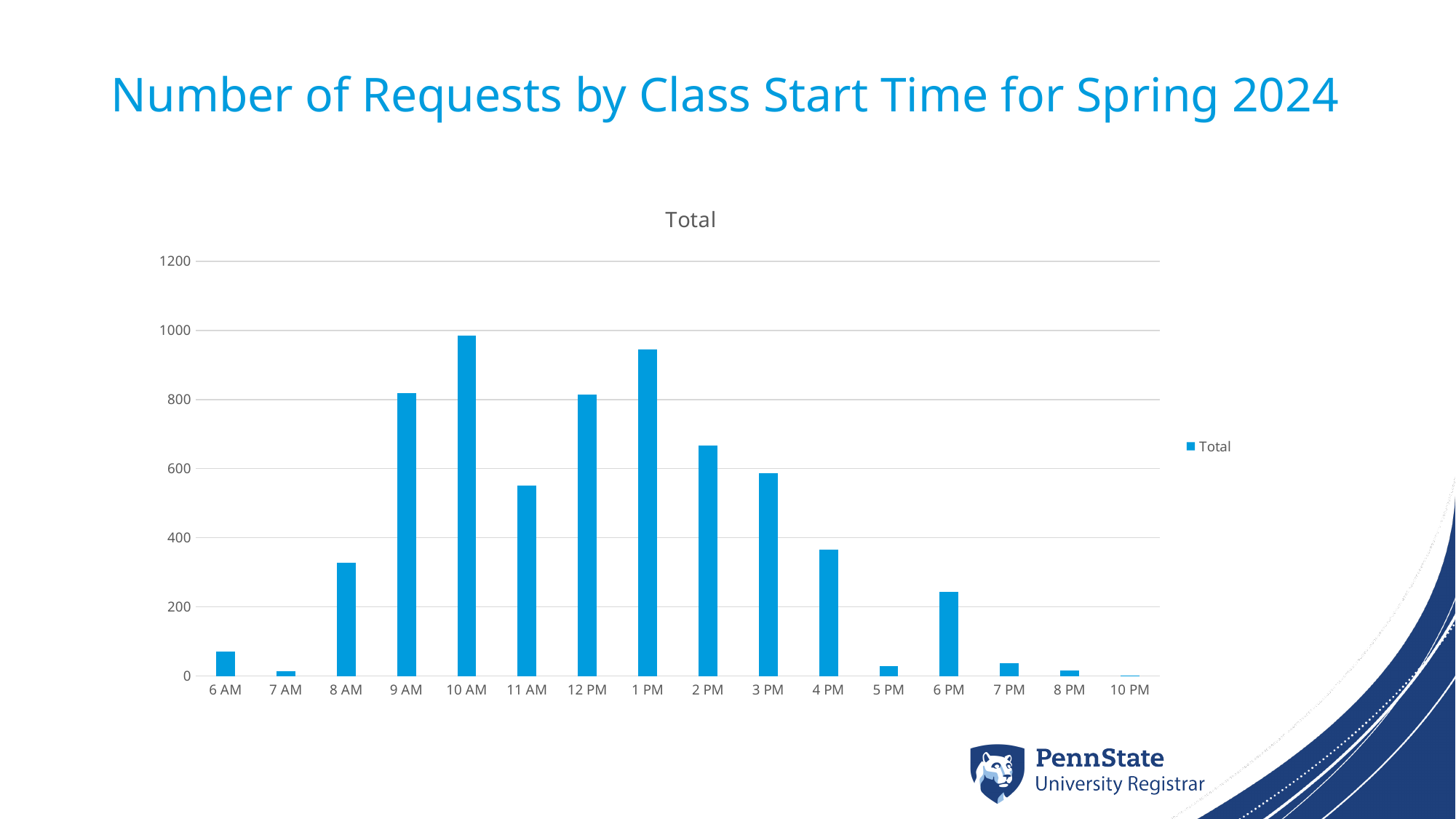
Do the values rise or fall from 1 PM to 5 PM? fall How many class start time categories are shown on the x axis? 16 How many series does the legend list? 1 Is the value for 10 AM greater or less than 800? greater Which class start time has the highest number of requests? 10 AM What is the title of the chart? Total Is the value for 2 PM greater or less than 600? greater Which has more requests, 2 PM or 3 PM? 2 PM Is the value for 11 AM greater or less than 600? less What kind of chart is shown on the slide? bar chart Which class start time has the lowest number of requests? 10 PM